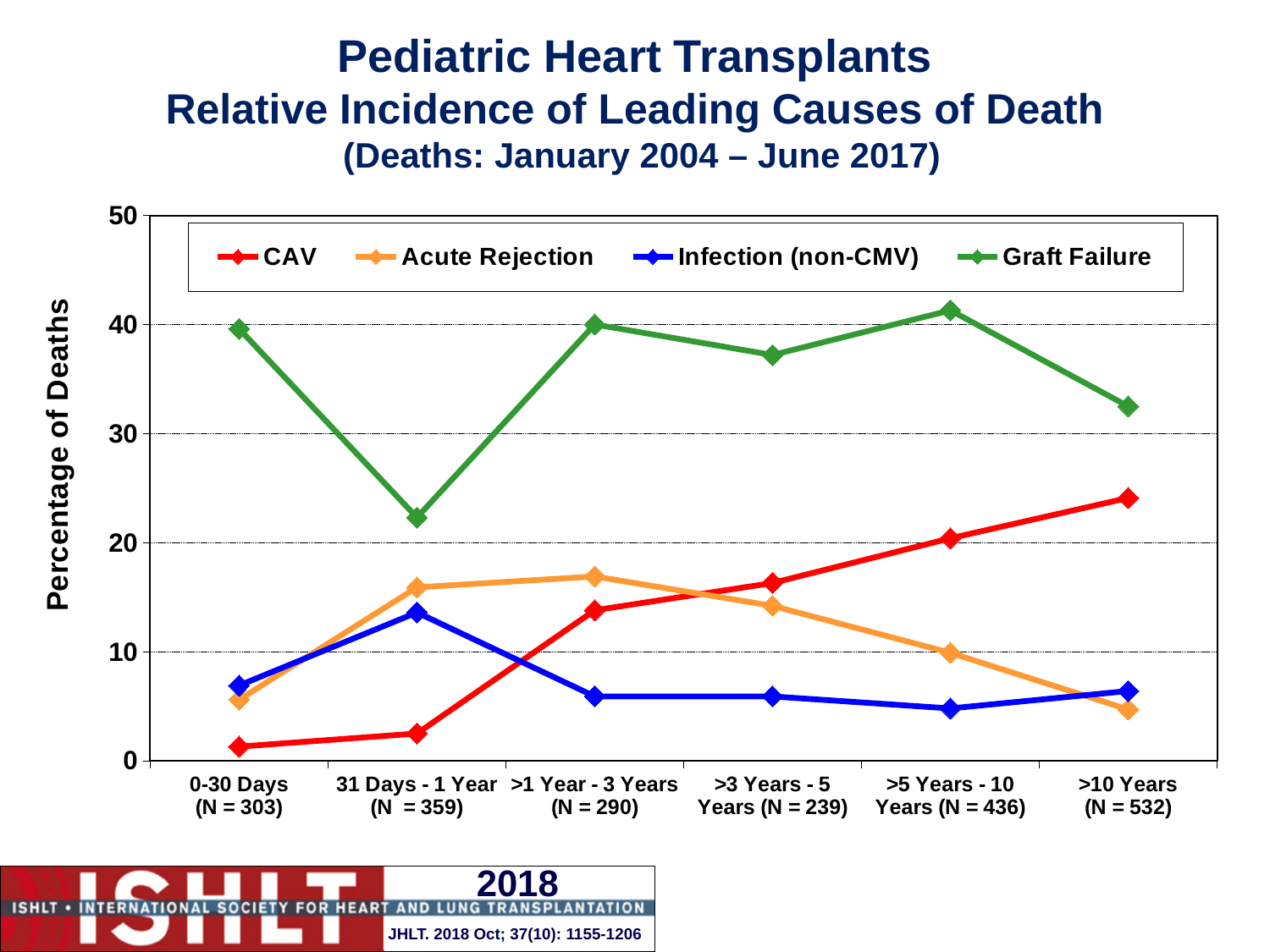
Which cause of death has the highest percentage at 0-30 Days? Graft Failure How many time-period categories are shown on the x axis? 6 Is the Graft Failure value for 0-30 Days greater or less than 30? greater What kind of chart is shown on the slide? line chart Is the CAV value for >10 Years greater or less than 20? greater Is the CAV value for 0-30 Days greater or less than 10? less What is the title of the y axis? Percentage of Deaths How many series does the legend list? 4 Does the CAV line rise or fall from 0-30 Days to >10 Years? rises At >10 Years, which is larger: CAV or Acute Rejection? CAV In which time period is the Graft Failure percentage lowest? 31 Days - 1 Year